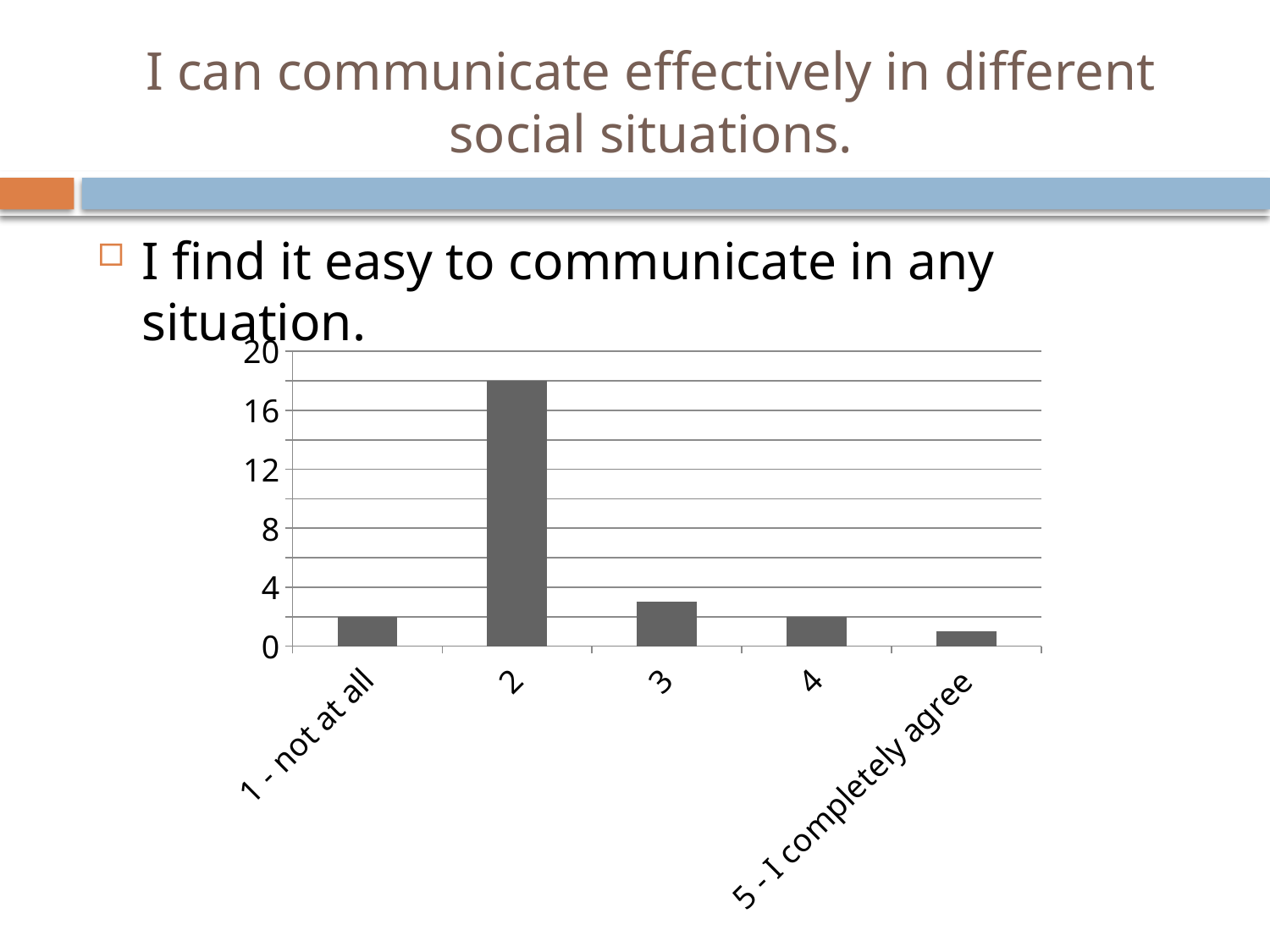
Is the value for category 2 greater or less than 16? greater Which has the larger value, category 3 or category 4? 3 What kind of chart is shown on the slide? bar chart Is the value for category 3 greater or less than 4? less Is the value for "1 - not at all" greater or less than 4? less What is the label of the first category on the x axis? 1 - not at all How many categories are shown on the x axis of the chart? 5 Which category has the lowest value in the chart? 5 - I completely agree Which category has the highest value in the chart? 2 What is the highest value shown on the y axis of the chart? 20 Which has the larger value, category 2 or category 3? 2